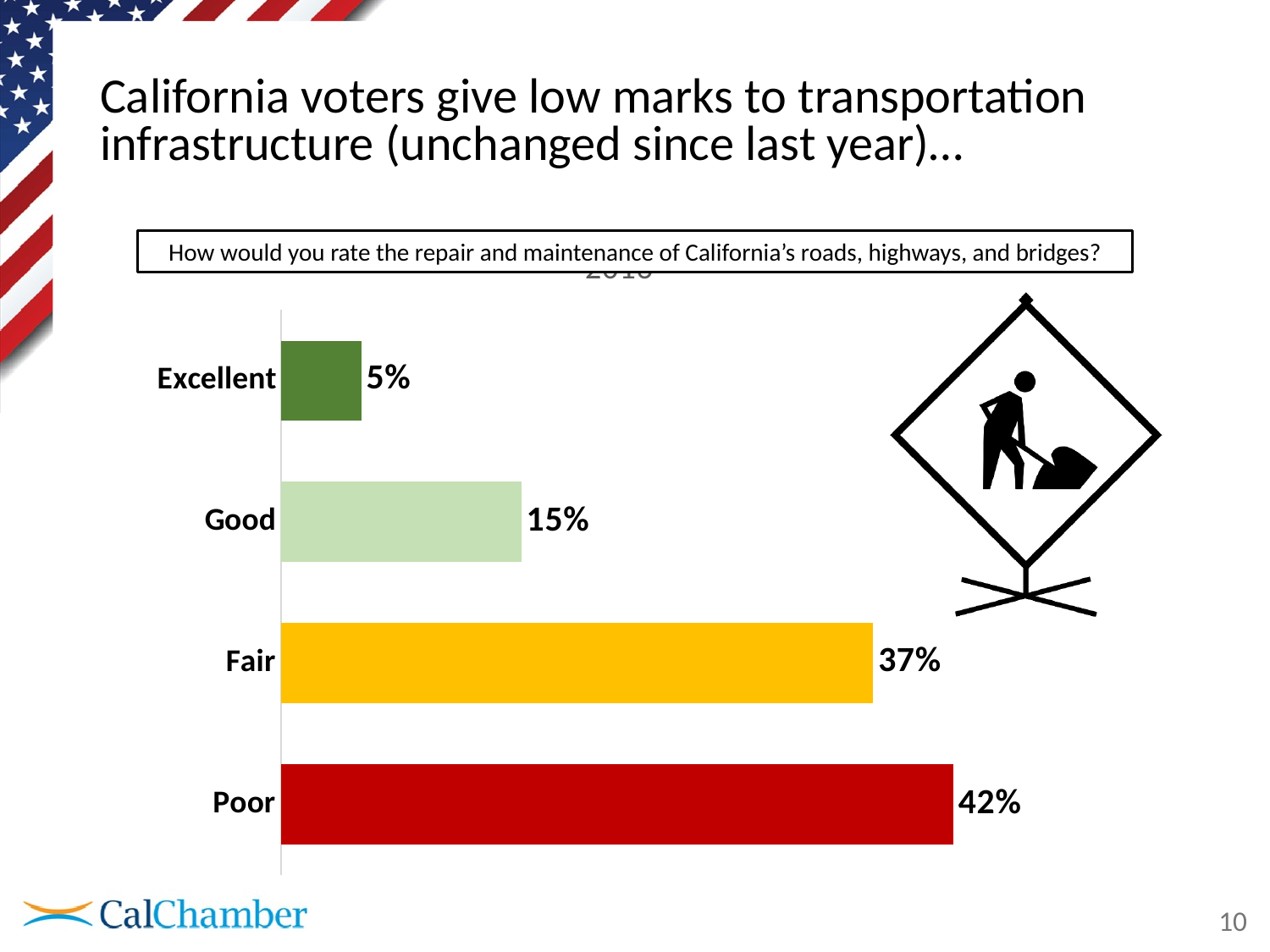
What percentage of voters gave a rating of Fair? 37% What percentage of voters rated the repair and maintenance of California's roads as Excellent? 5% What is the difference in percentage points between the Good and Excellent ratings? 10 Which rating category has the lowest percentage? Excellent Which rating received a larger share of voters, Good or Fair? Fair What percentage of voters gave a rating of Good? 15% What type of chart is used to show the ratings? Bar chart What colour is the bar for the Poor rating? Red What percentage of voters rated the repair and maintenance of California's roads as Poor? 42% What is the difference in percentage points between the Poor and Fair ratings? 5 How many rating categories are shown in the chart? 4 Which rating category has the highest percentage? Poor